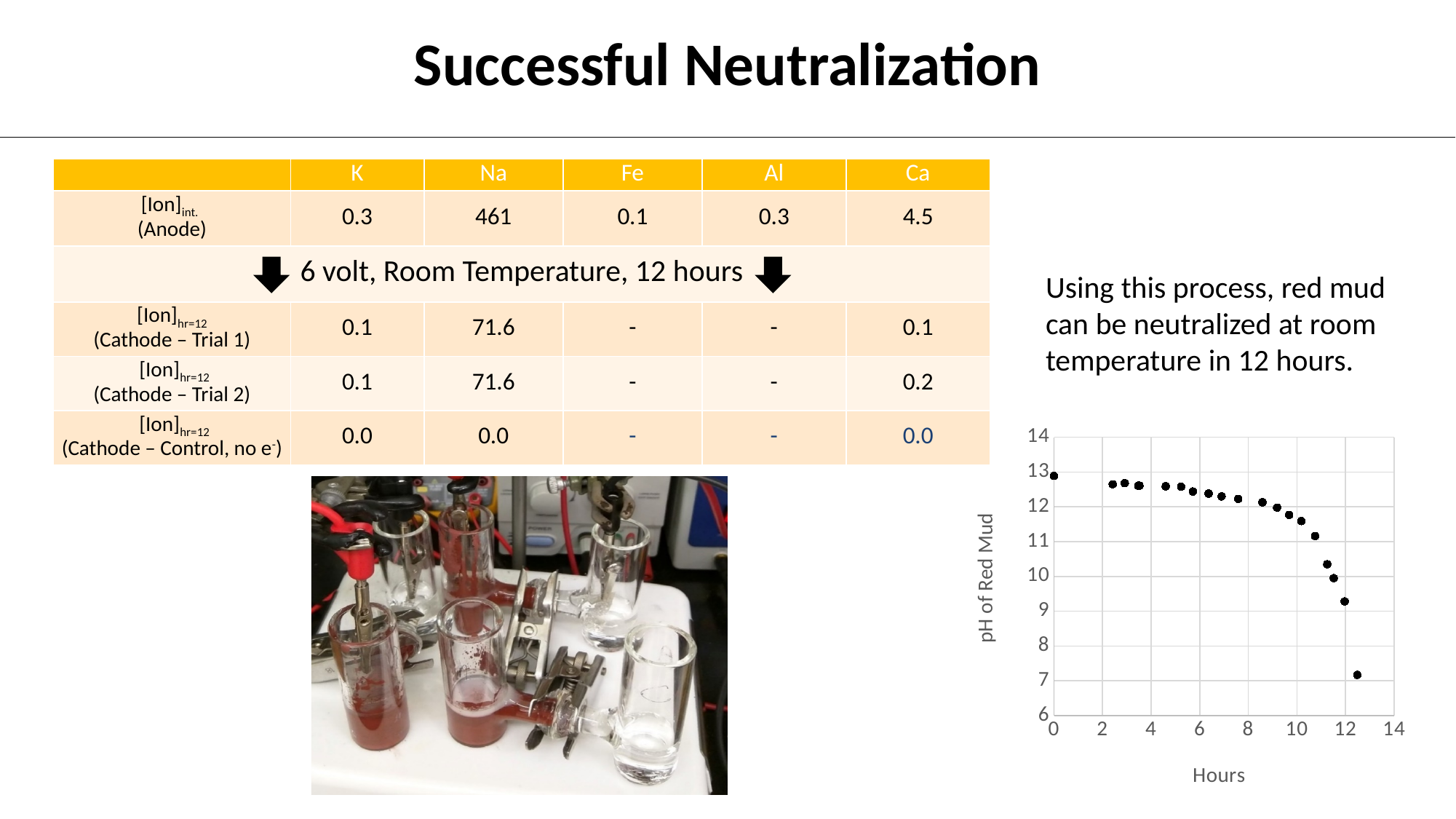
In the pH chart, is the pH value at 10 hours greater or less than 11? greater In the pH chart, is the pH value at 6 hours greater or less than 12? greater In the pH chart, does the pH of red mud rise or fall as the hours increase? fall In the pH chart, which is larger: the pH at 0 hours or the pH at 12 hours? the pH at 0 hours In the pH chart, is the final pH value (at about 12.5 hours) greater or less than 8? less What is the label of the horizontal axis of the chart? Hours What is the label of the vertical axis of the chart? pH of Red Mud What kind of chart is shown on the right of the slide? scatter chart